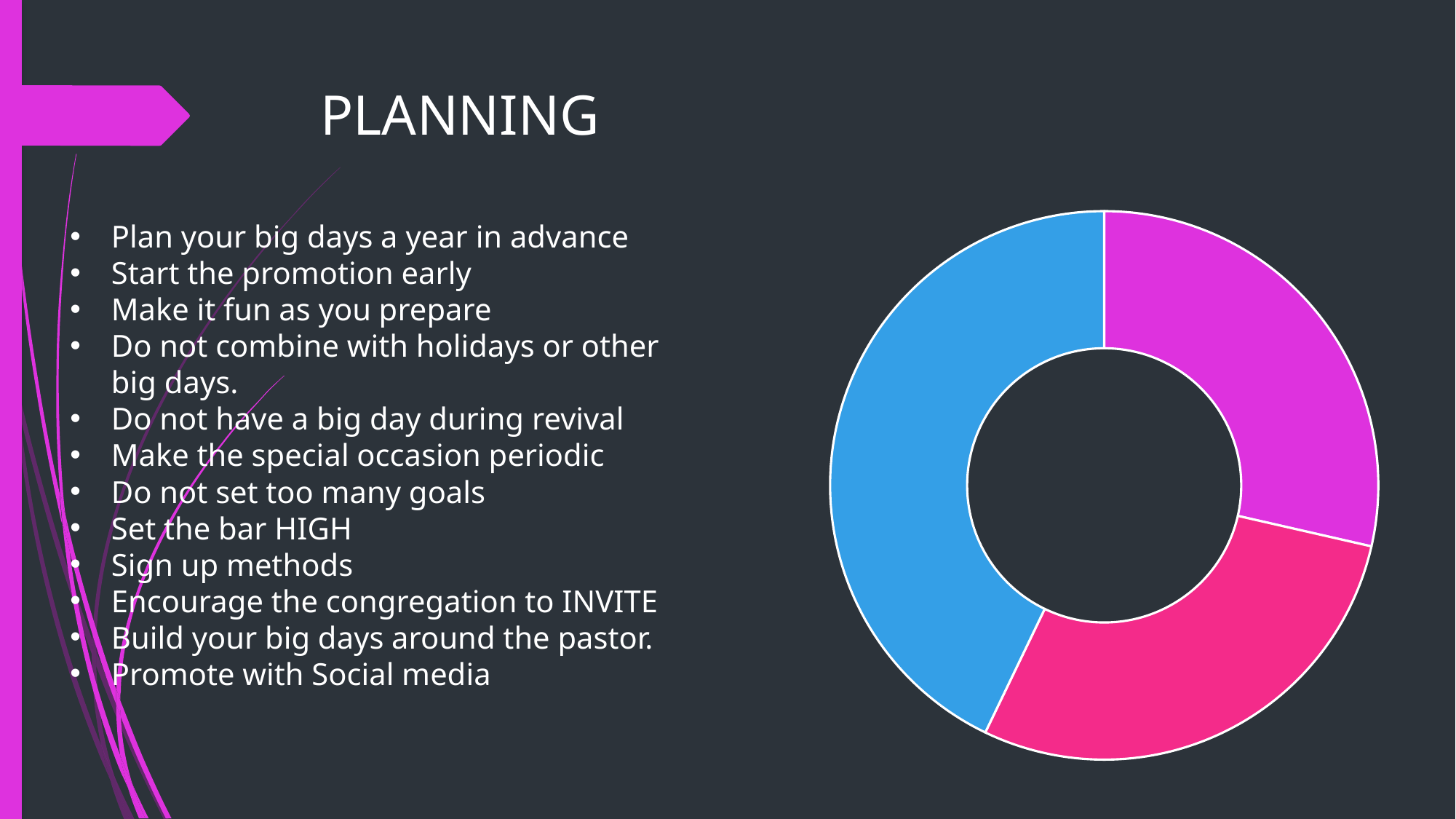
What kind of chart is shown on the right side of the slide? Doughnut chart How many slices does the doughnut chart on the slide have? 3 Is the blue slice of the doughnut chart larger than the pink slice? Yes Which colour slice is the largest in the doughnut chart? Blue Does the doughnut chart on the slide display a legend? No Is the blue slice of the doughnut chart larger than the purple slice? Yes Does the doughnut chart on the slide show any data labels? No